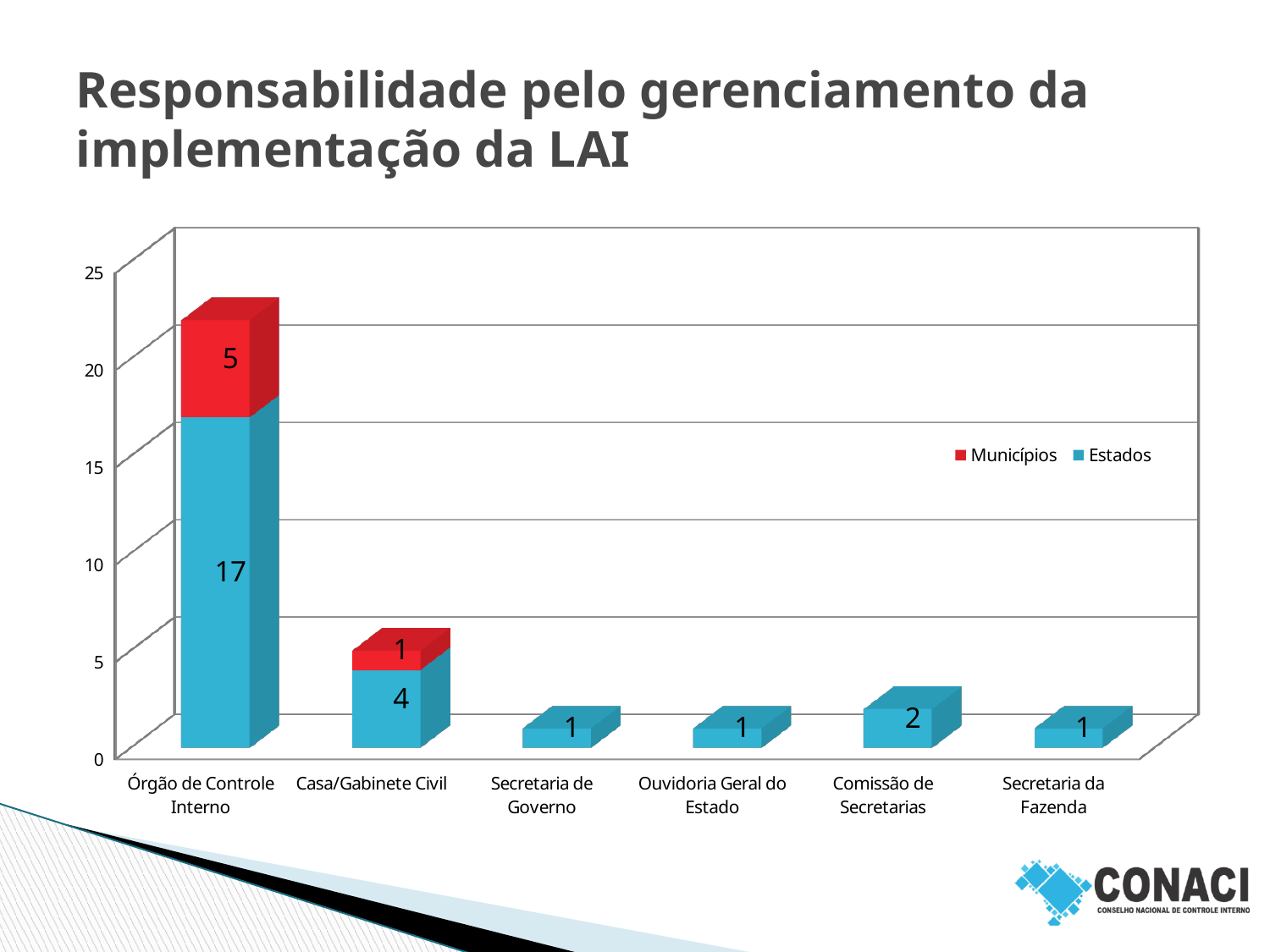
What kind of chart is shown on the slide? Stacked bar chart What is the Estados value for Casa/Gabinete Civil? 4 What is the total of the stacked bar for Órgão de Controle Interno? 22 Which is larger: the Estados value for Comissão de Secretarias or for Secretaria da Fazenda? Comissão de Secretarias What is the Municípios value for Órgão de Controle Interno? 5 What is the total of the stacked bar for Casa/Gabinete Civil? 5 Which category has the highest Estados value? Órgão de Controle Interno How many categories are shown on the x axis? 6 How many series does the legend list? 2 What is the Estados value for Comissão de Secretarias? 2 What is the difference between the Estados values for Órgão de Controle Interno and Casa/Gabinete Civil? 13 What is the Estados value for Órgão de Controle Interno? 17